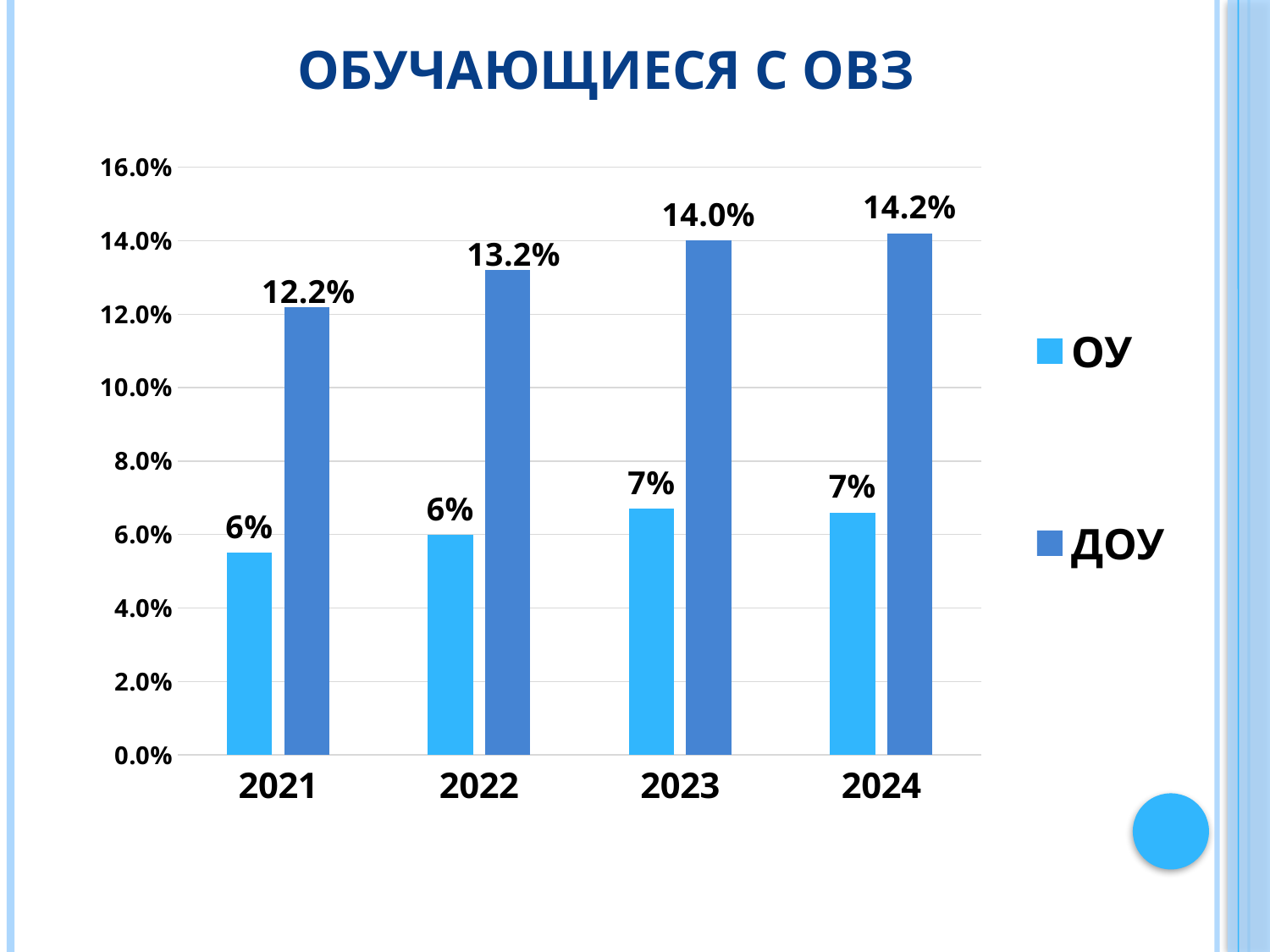
What is the value for ОУ in 2022? 6% What is the value for ДОУ in 2023? 14.0% How many series does the legend list? 2 In which year is the ДОУ value highest? 2024 In which year is the ДОУ value lowest? 2021 What is the difference between the ДОУ values for 2024 and 2021? 2.0% How many years are shown on the x axis? 4 What is the value for ОУ in 2024? 7% Do the ДОУ values rise or fall from 2021 to 2024? rise Which is larger in 2022: the ОУ value or the ДОУ value? ДОУ Is the value for ОУ in 2023 greater or less than 6.0%? greater What is the value for ДОУ in 2021? 12.2%